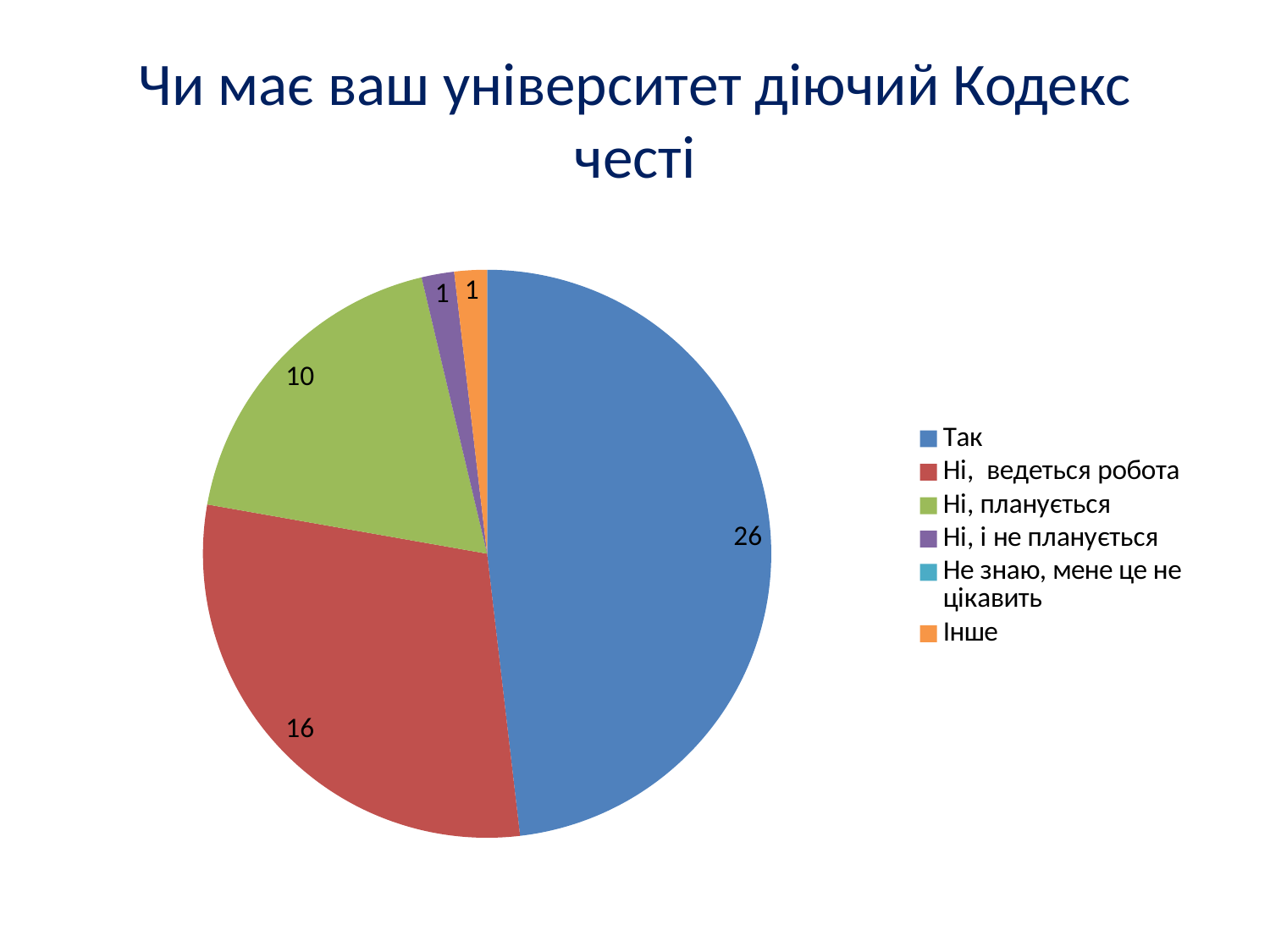
What is the value for the "Ні, планується" slice? 10 What is the difference between the values for "Так" and "Ні, ведеться робота"? 10 What is the value for the "Ні, ведеться робота" slice? 16 What is the difference between the values for "Ні, ведеться робота" and "Ні, планується"? 6 How many categories does the legend list? 6 What is the value for the "Так" slice? 26 What colour is the "Так" slice? blue What is the title of the slide? Чи має ваш університет діючий Кодекс честі What type of chart is shown on the slide? pie chart Which is larger, the value for "Ні, планується" or the value for "Ні, і не планується"? Ні, планується Which category has the largest slice of the pie? Так What is the value for the "Інше" slice? 1